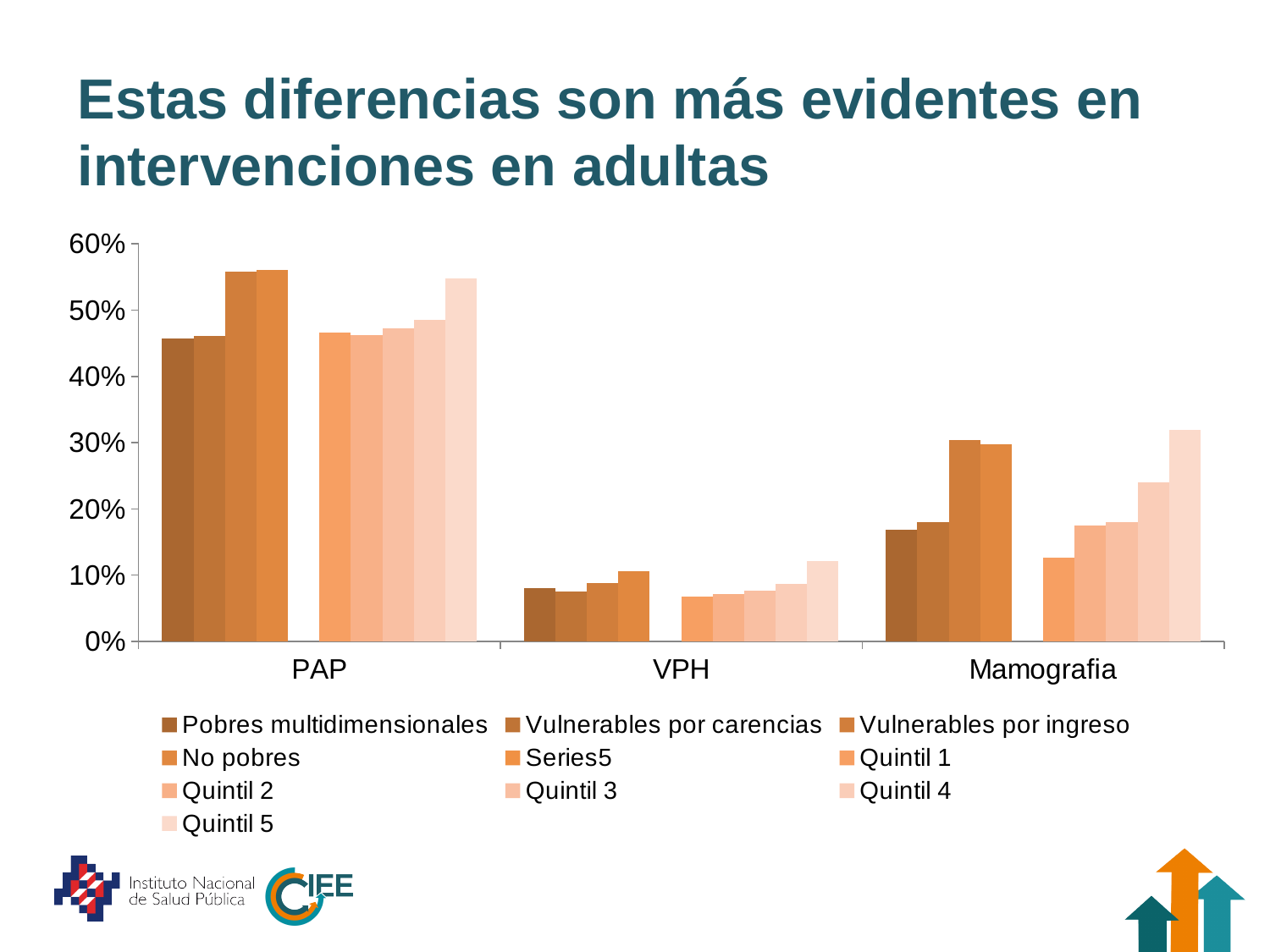
What is the title of the slide containing the chart? Estas diferencias son más evidentes en intervenciones en adultas How many series does the chart legend list? 10 Is the value for No pobres in the PAP category greater or less than 50%? greater Is the value for Pobres multidimensionales in the Mamografia category greater or less than 20%? less Is the value for Quintil 5 in the PAP category greater or less than 50%? greater What kind of chart is shown on the slide? bar chart Which category on the x axis has the lowest values overall? VPH How many categories are shown on the x axis of the chart? 3 Which category on the x axis has the highest values overall? PAP In the Mamografia category, which is larger: the value for Quintil 1 or the value for Quintil 5? Quintil 5 In the Mamografia category, do the values rise or fall from Quintil 1 to Quintil 5? rise